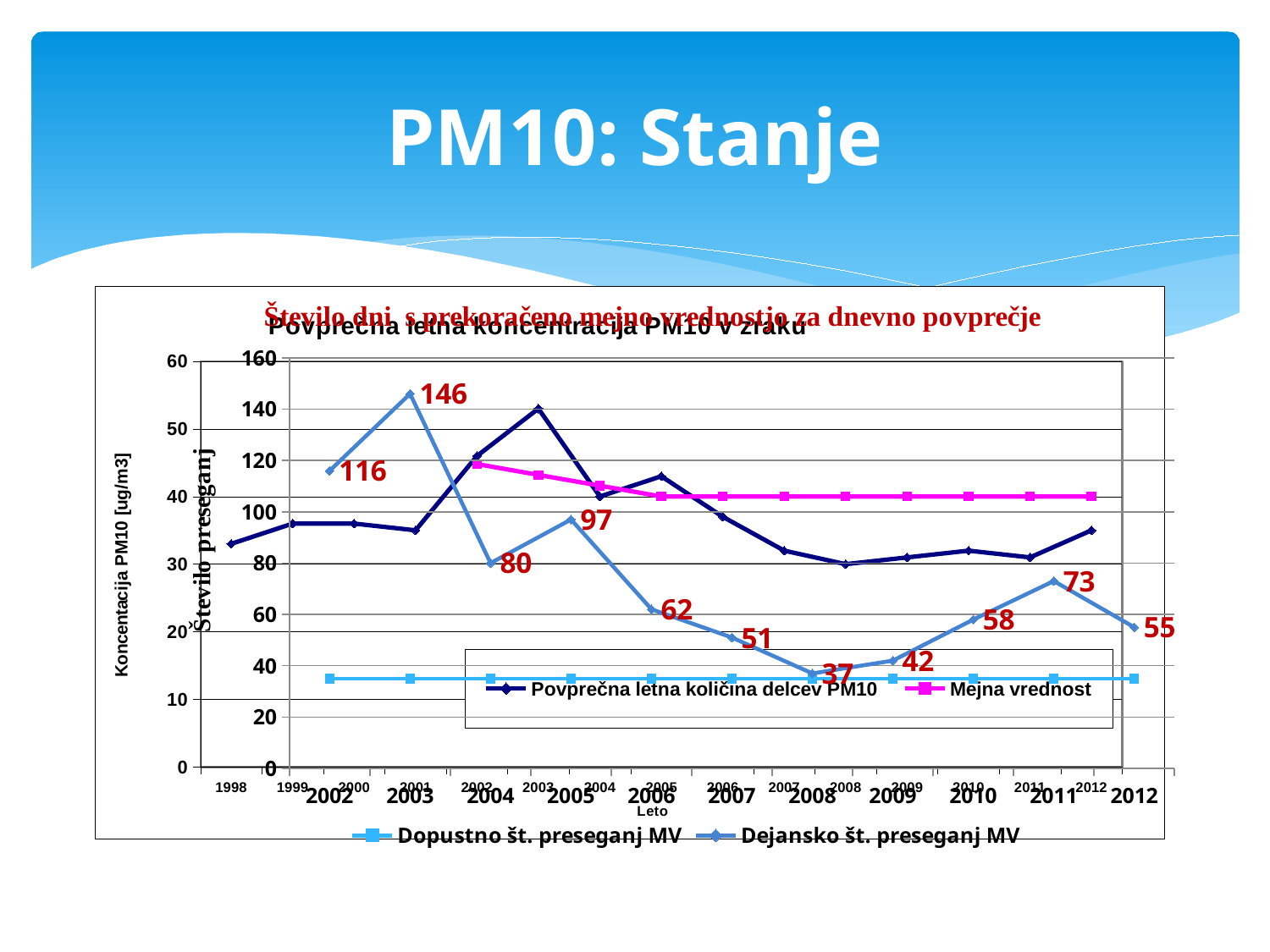
In the chart 'Število dni s prekoračeno mejno vrednostjo za dnevno povprečje', what is the value of Dejansko št. preseganj MV for 2012? 55 In the chart 'Povprečna letna koncentracija PM10 v zraku', which two series does the legend list? Povprečna letna količina delcev PM10 and Mejna vrednost In the chart 'Število dni s prekoračeno mejno vrednostjo za dnevno povprečje', does Dejansko št. preseganj MV rise or fall from 2008 to 2011? rise In the chart 'Število dni s prekoračeno mejno vrednostjo za dnevno povprečje', what is the difference between the Dejansko št. preseganj MV values for 2003 and 2002? 30 In the chart 'Število dni s prekoračeno mejno vrednostjo za dnevno povprečje', which year has the highest Dejansko št. preseganj MV? 2003 In the chart 'Število dni s prekoračeno mejno vrednostjo za dnevno povprečje', which year has the larger Dejansko št. preseganj MV, 2010 or 2011? 2011 What kind of chart is 'Povprečna letna koncentracija PM10 v zraku'? line chart In the chart 'Število dni s prekoračeno mejno vrednostjo za dnevno povprečje', how many years are shown on the x axis? 11 In the chart 'Število dni s prekoračeno mejno vrednostjo za dnevno povprečje', which year has the lowest Dejansko št. preseganj MV? 2008 In the chart 'Število dni s prekoračeno mejno vrednostjo za dnevno povprečje', how many series does the legend list? 2 In the chart 'Število dni s prekoračeno mejno vrednostjo za dnevno povprečje', what is the value of Dejansko št. preseganj MV for 2003? 146 In the chart 'Število dni s prekoračeno mejno vrednostjo za dnevno povprečje', what is the value of Dejansko št. preseganj MV for 2008? 37